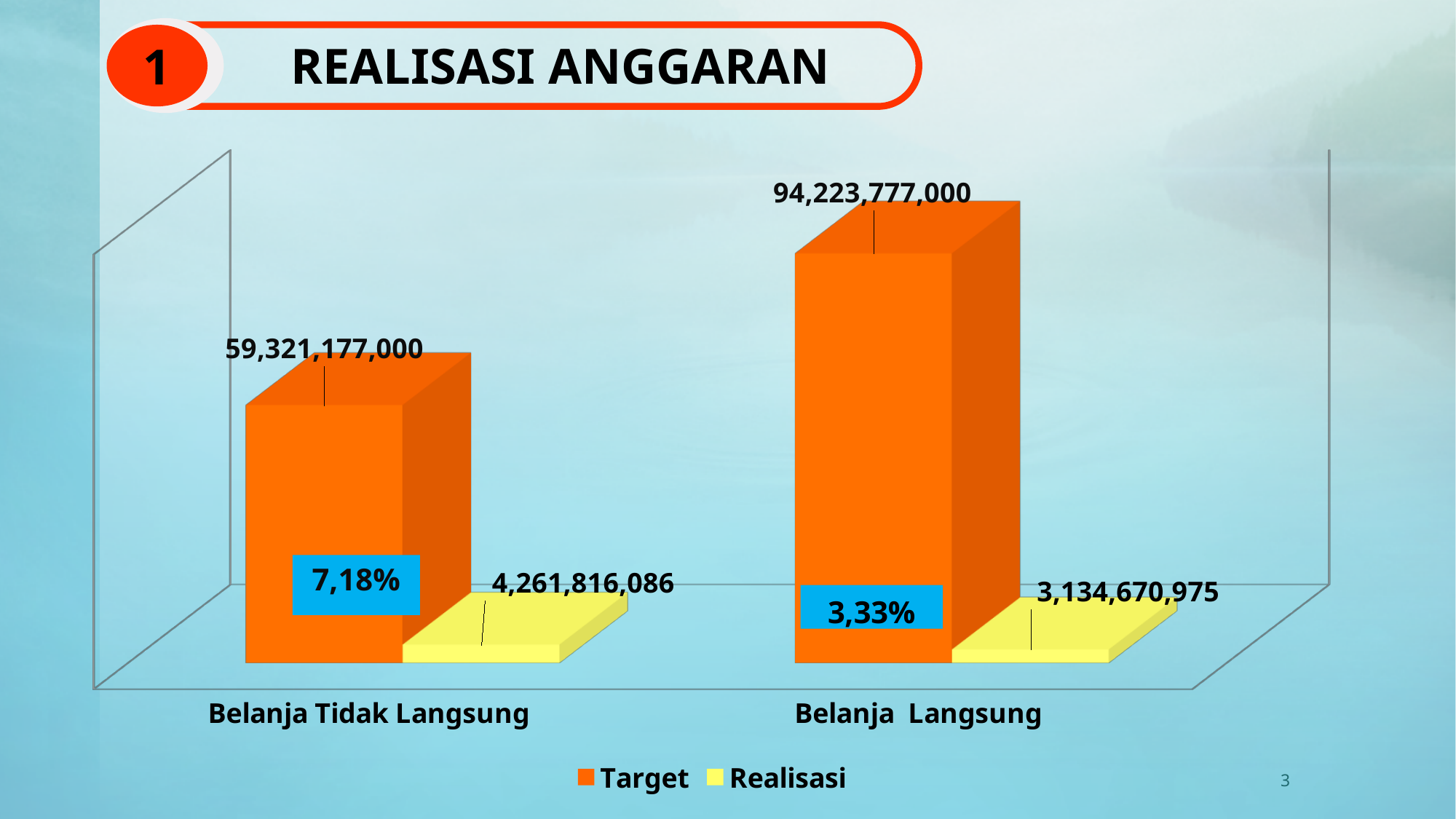
How many series does the legend list? 2 Is the Realisasi value for Belanja Tidak Langsung larger or smaller than the Realisasi value for Belanja Langsung? larger What is the Realisasi value for Belanja Tidak Langsung? 4,261,816,086 Which category has the lower Realisasi value? Belanja Langsung What is the difference between the Target values for Belanja Langsung and Belanja Tidak Langsung? 34,902,600,000 What is the difference between the Realisasi values for Belanja Tidak Langsung and Belanja Langsung? 1,127,145,111 What is the Realisasi value for Belanja Langsung? 3,134,670,975 What kind of chart is shown on the slide? bar chart What is the Target value for Belanja Langsung? 94,223,777,000 Which category has the higher Target value? Belanja Langsung How many categories are shown on the x axis? 2 What is the Target value for Belanja Tidak Langsung? 59,321,177,000